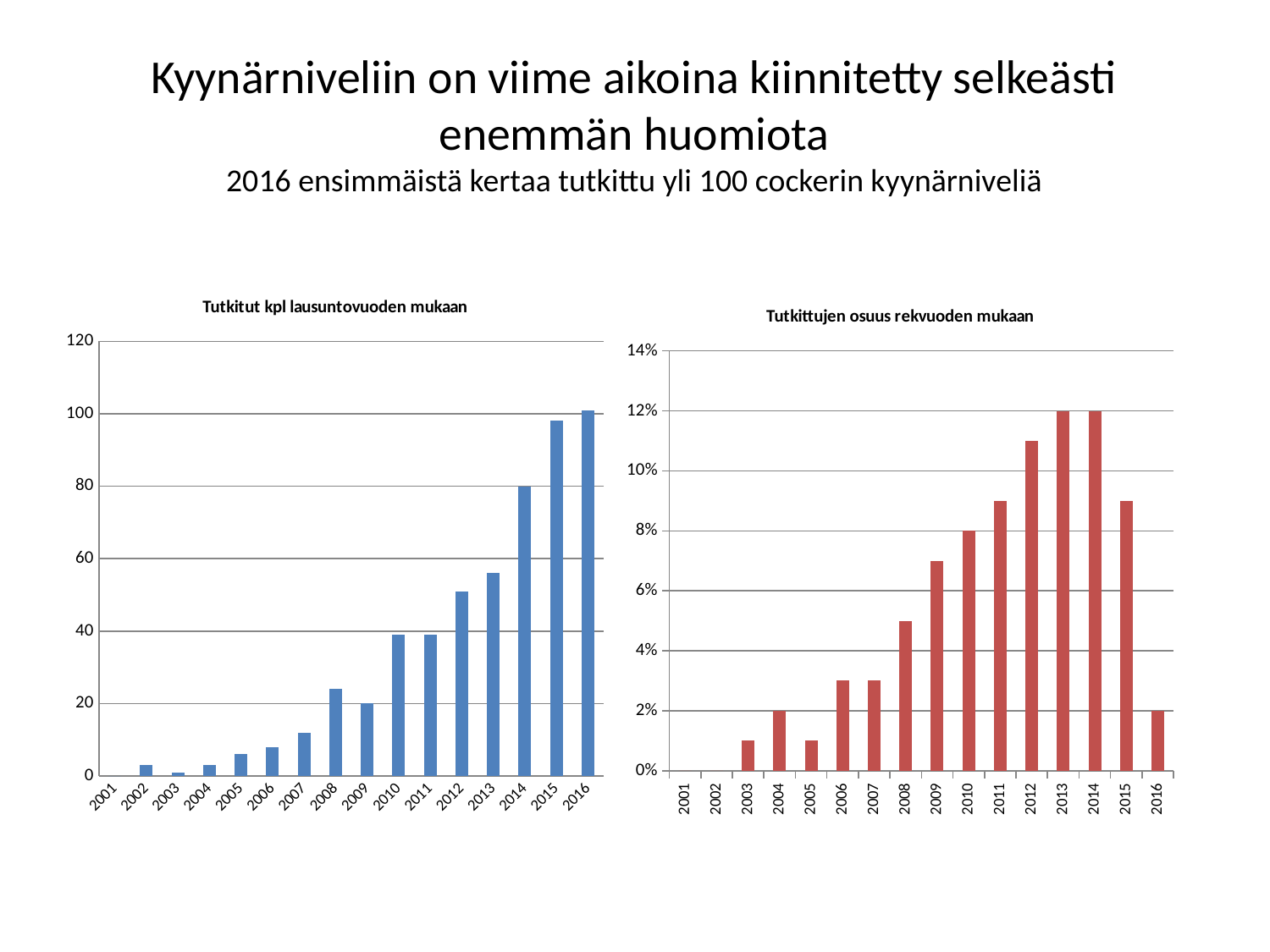
In the left chart 'Tutkitut kpl lausuntovuoden mukaan', what is the value for 2009? 20 In the right chart 'Tutkittujen osuus rekvuoden mukaan', is the value for 2012 greater or less than 10%? greater In the right chart 'Tutkittujen osuus rekvuoden mukaan', which is larger, the value for 2015 or the value for 2016? 2015 In the left chart 'Tutkitut kpl lausuntovuoden mukaan', what is the difference between the values for 2014 and 2009? 60 In the left chart 'Tutkitut kpl lausuntovuoden mukaan', is the value for 2012 greater or less than 40? greater What kind of chart is the left chart titled 'Tutkitut kpl lausuntovuoden mukaan'? bar chart In the right chart 'Tutkittujen osuus rekvuoden mukaan', what is the value for 2010? 8% In the left chart 'Tutkitut kpl lausuntovuoden mukaan', what is the value for 2014? 80 In the right chart 'Tutkittujen osuus rekvuoden mukaan', what is the value for 2016? 2% In the left chart 'Tutkitut kpl lausuntovuoden mukaan', how many years are shown on the x axis? 16 In the left chart 'Tutkitut kpl lausuntovuoden mukaan', which year has the highest value? 2016 In the left chart 'Tutkitut kpl lausuntovuoden mukaan', is the value for 2016 greater or less than 100? greater